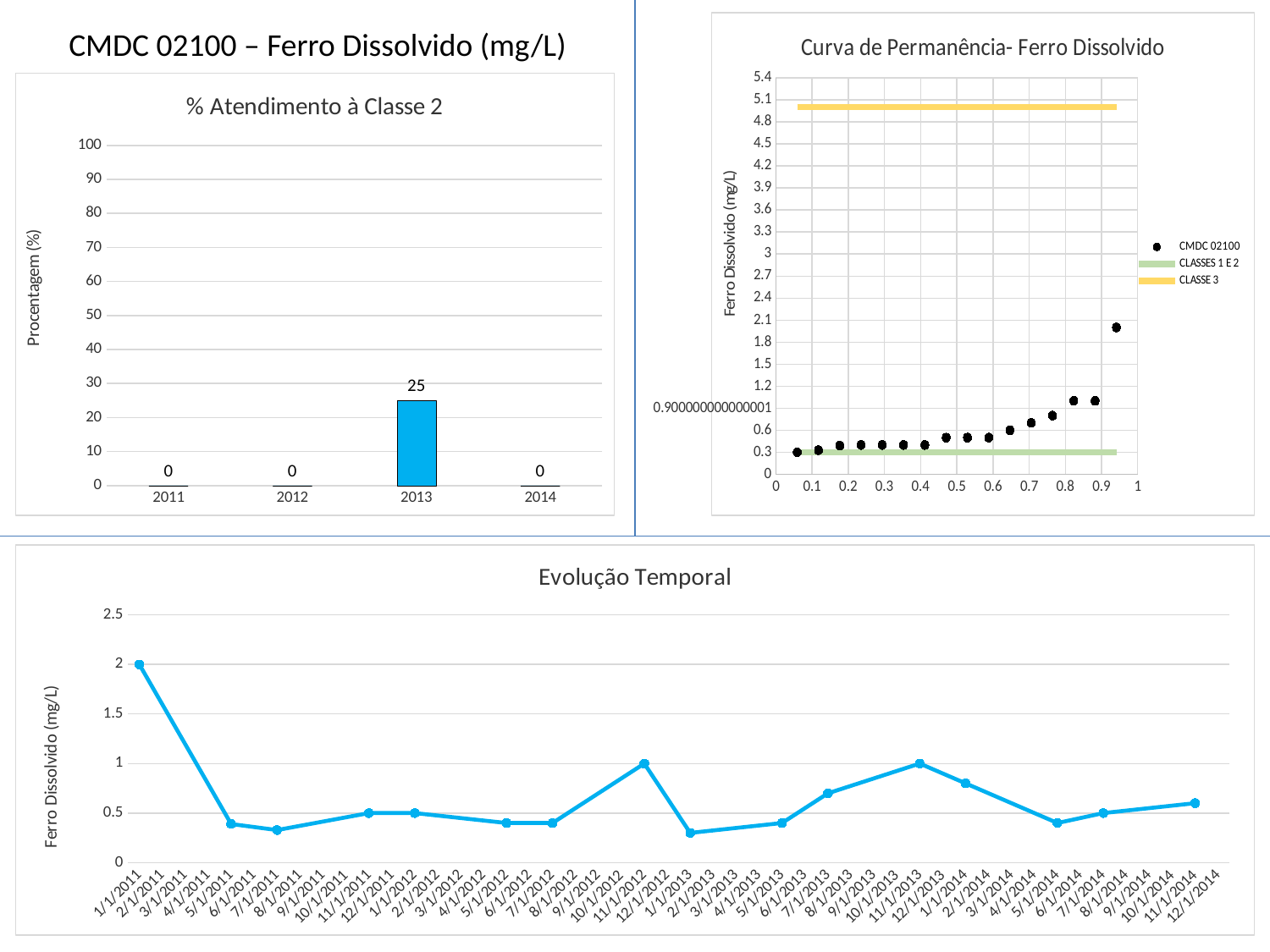
In the 'Evolução Temporal' chart, which is larger, the value for 1/1/2011 or the value for 5/1/2011? 1/1/2011 In the '% Atendimento à Classe 2' chart, what is the value for 2013? 25 In the 'Evolução Temporal' chart, is the value for 1/1/2013 greater or less than 0.5? less In the 'Evolução Temporal' chart, is the value for 1/1/2011 greater or less than 1.5? greater What kind of chart is the '% Atendimento à Classe 2' chart? bar chart In the 'Curva de Permanência- Ferro Dissolvido' chart, how many series does the legend list? 3 In the '% Atendimento à Classe 2' chart, what is the value for 2011? 0 In the '% Atendimento à Classe 2' chart, how many years are shown on the x axis? 4 In the 'Curva de Permanência- Ferro Dissolvido' chart, what is the label of the y axis? Ferro Dissolvido (mg/L) In the '% Atendimento à Classe 2' chart, what is the difference between the values for 2013 and 2014? 25 In the '% Atendimento à Classe 2' chart, which year has the highest value? 2013 In the '% Atendimento à Classe 2' chart, is the value for 2013 greater or less than 30? less